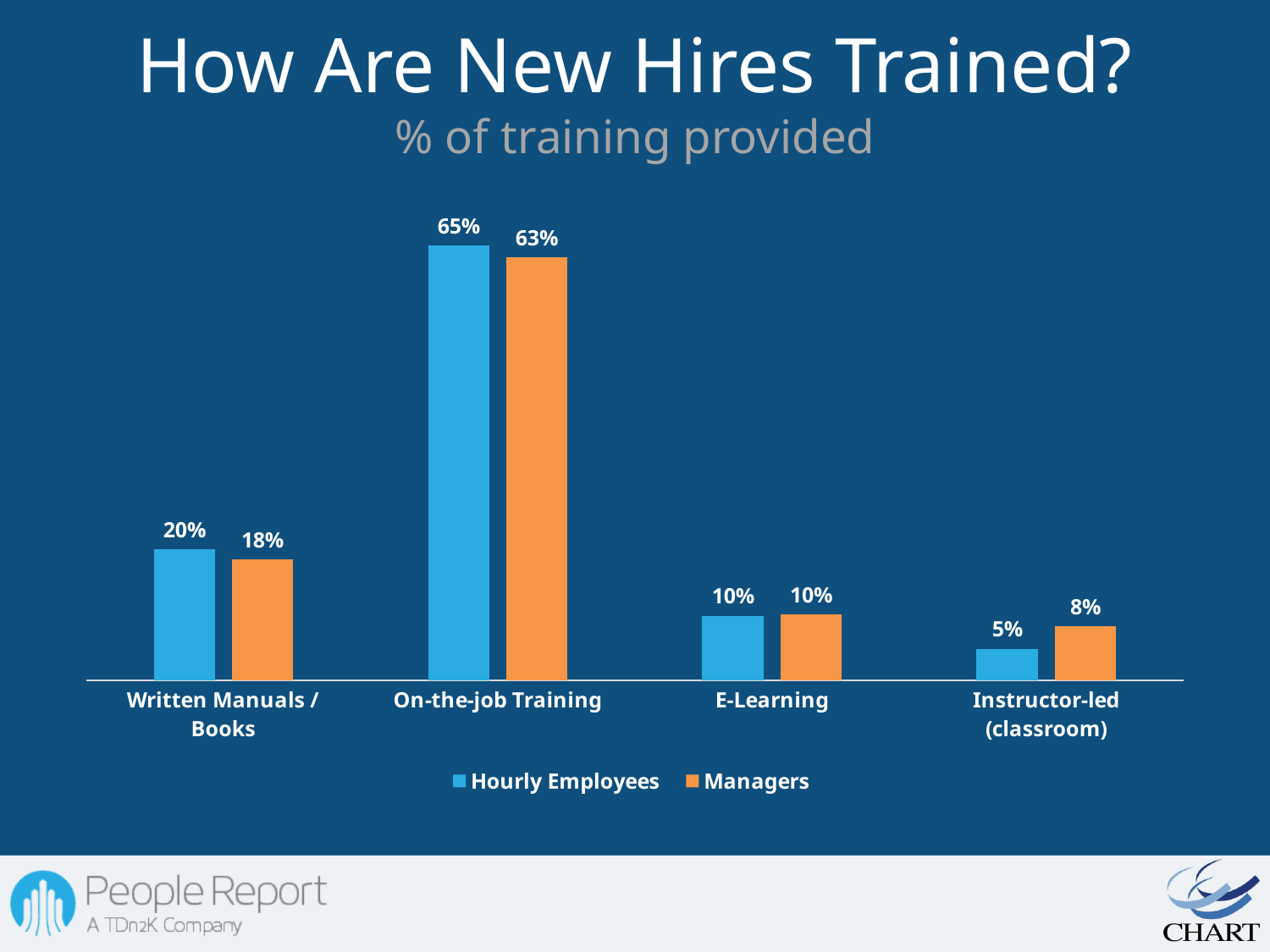
What percentage of training for Managers is Written Manuals / Books? 18% What kind of chart is shown on the slide? Bar chart What is the value for Managers in the Instructor-led (classroom) category? 8% How many series does the legend list? 2 Which training category has the lowest value for Managers? Instructor-led (classroom) How many training categories are shown on the x axis? 4 What is the difference between the Managers and Hourly Employees values for Instructor-led (classroom)? 3% Which training category has the highest value for Hourly Employees? On-the-job Training What is the difference between the Hourly Employees and Managers values for On-the-job Training? 2% What is the subtitle shown below the chart title? % of training provided For Written Manuals / Books, which series has the larger value, Hourly Employees or Managers? Hourly Employees What percentage of training for Hourly Employees is On-the-job Training? 65%